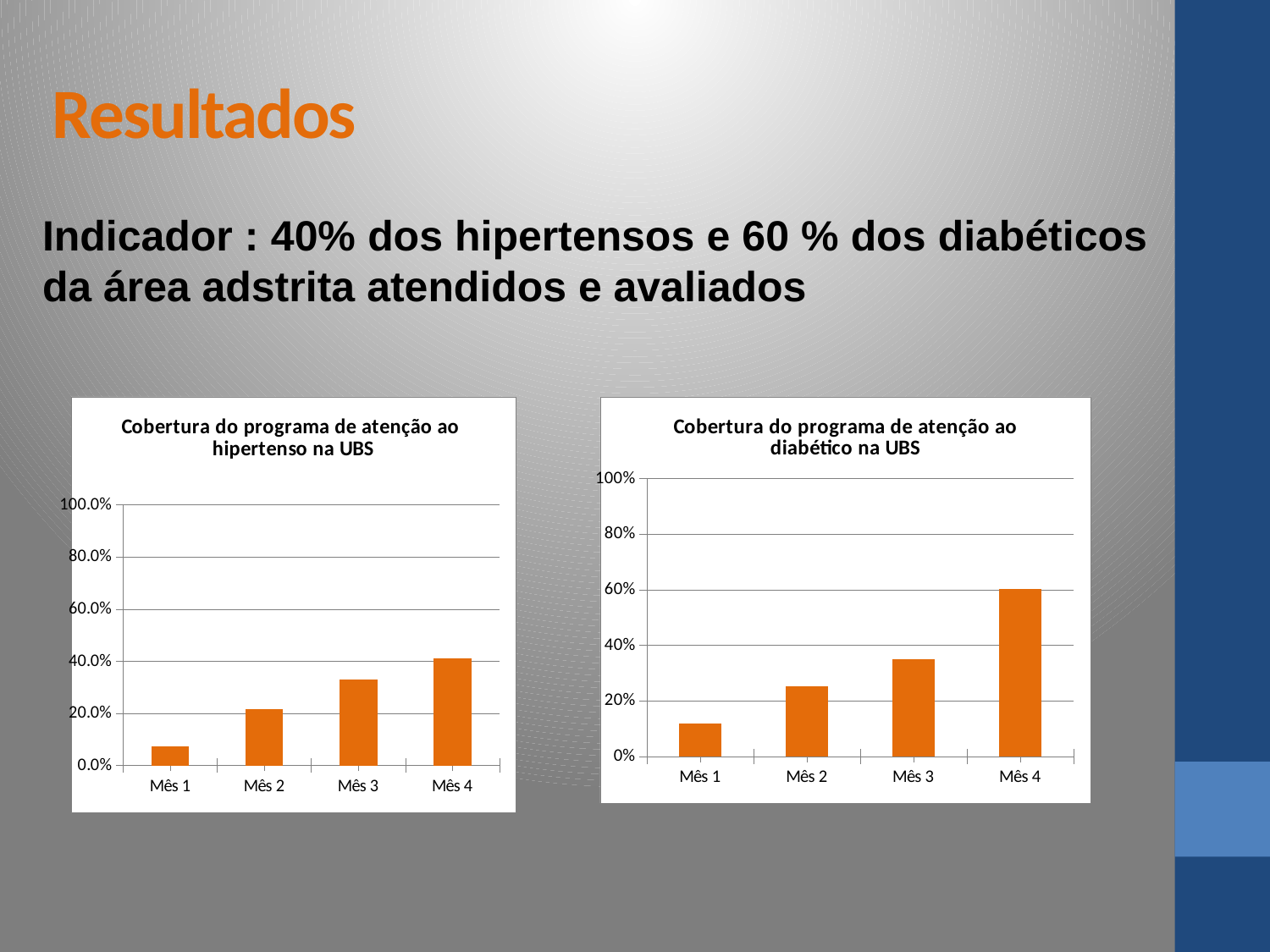
In the right chart, 'Cobertura do programa de atenção ao diabético na UBS', is the value for Mês 1 greater or less than 20%? less In the right chart, 'Cobertura do programa de atenção ao diabético na UBS', which month has the highest value? Mês 4 In the left chart, 'Cobertura do programa de atenção ao hipertenso na UBS', which is larger, the value for Mês 2 or the value for Mês 3? Mês 3 What kind of chart is the left chart, 'Cobertura do programa de atenção ao hipertenso na UBS'? bar chart In the right chart, 'Cobertura do programa de atenção ao diabético na UBS', is the value for Mês 3 greater or less than 20%? greater How many categories are shown on the x axis of the right chart, 'Cobertura do programa de atenção ao diabético na UBS'? 4 What is the title of the right chart on the slide? Cobertura do programa de atenção ao diabético na UBS In the left chart, 'Cobertura do programa de atenção ao hipertenso na UBS', do the values rise or fall from Mês 1 to Mês 4? rise In the right chart, 'Cobertura do programa de atenção ao diabético na UBS', do the values rise or fall from Mês 1 to Mês 4? rise In the left chart, 'Cobertura do programa de atenção ao hipertenso na UBS', which month has the lowest value? Mês 1 What colour are the bars in the left chart, 'Cobertura do programa de atenção ao hipertenso na UBS'? orange In the left chart, 'Cobertura do programa de atenção ao hipertenso na UBS', is the value for Mês 4 greater or less than 60.0%? less